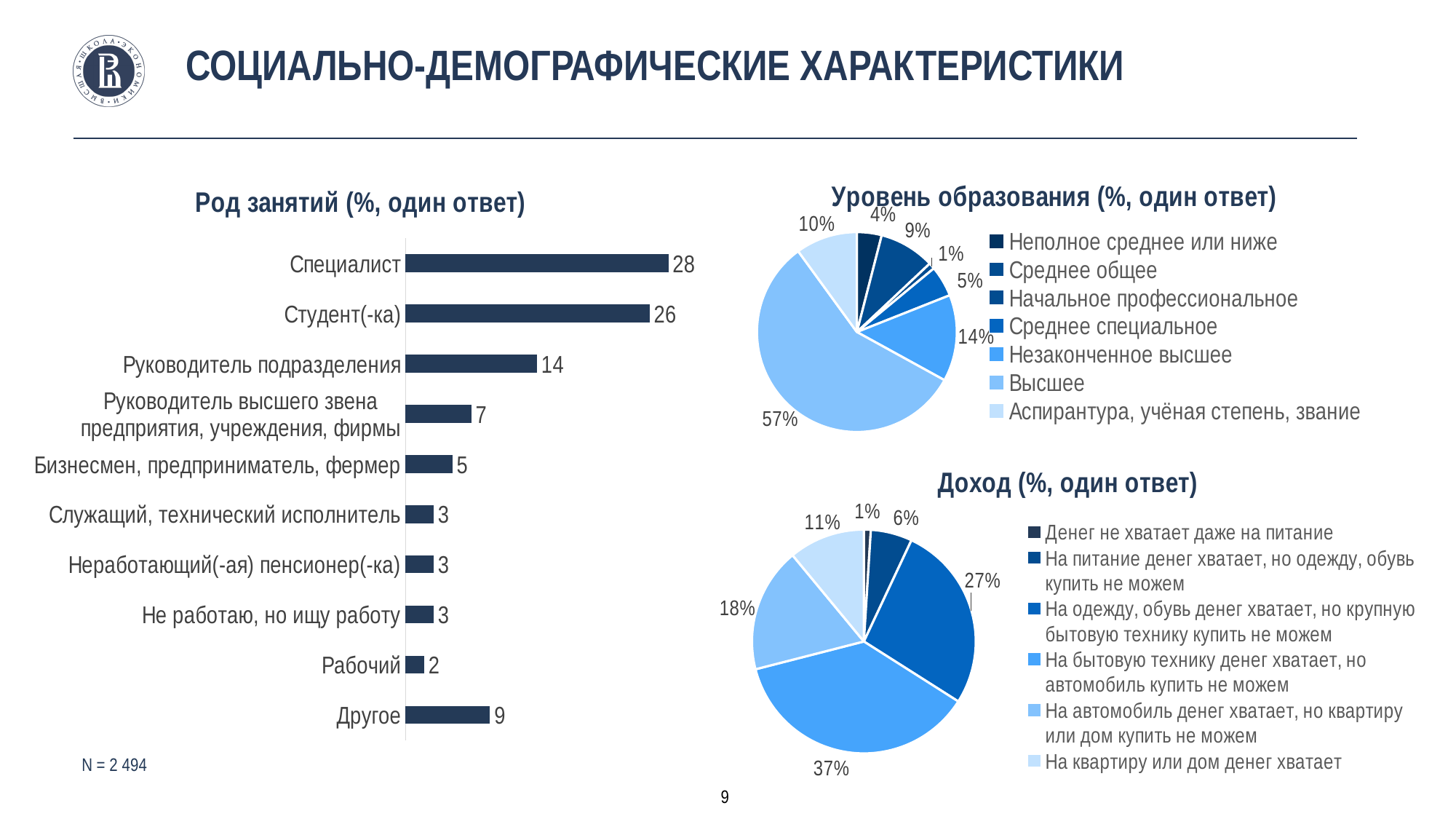
On the 'Род занятий (%, один ответ)' chart, which category has the lowest value? Рабочий On the 'Уровень образования (%, один ответ)' pie chart, what share is Высшее? 57% What kind of chart is 'Род занятий (%, один ответ)'? Bar chart On the 'Род занятий (%, один ответ)' chart, how many categories are shown? 10 On the 'Доход (%, один ответ)' pie chart, which is larger: 'На одежду, обувь денег хватает, но крупную бытовую технику купить не можем' or 'На квартиру или дом денег хватает'? На одежду, обувь денег хватает, но крупную бытовую технику купить не можем On the 'Доход (%, один ответ)' pie chart, which category has the largest share? На бытовую технику денег хватает, но автомобиль купить не можем On the 'Род занятий (%, один ответ)' chart, what is the difference between Специалист and Студент(-ка)? 2 On the 'Род занятий (%, один ответ)' chart, what is the value for Руководитель подразделения? 14 On the 'Доход (%, один ответ)' pie chart, what share is 'На автомобиль денег хватает, но квартиру или дом купить не можем'? 18% On the 'Род занятий (%, один ответ)' chart, what is the value for Специалист? 28 On the 'Уровень образования (%, один ответ)' pie chart, what share is Незаконченное высшее? 14% How many entries does the legend of the 'Уровень образования (%, один ответ)' chart list? 7